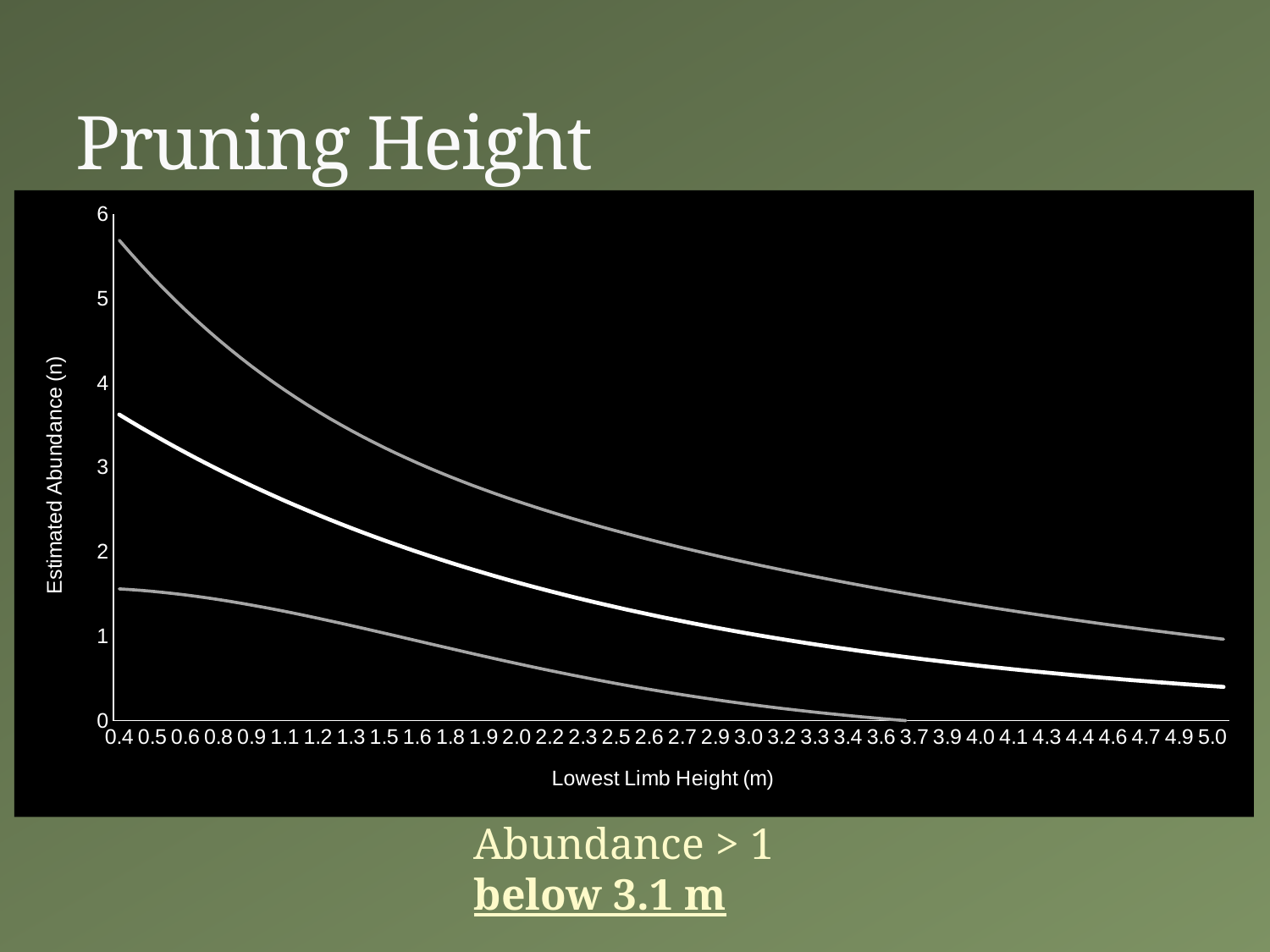
As Lowest Limb Height increases along the x axis, does the upper grey line rise or fall? Fall At a Lowest Limb Height of 0.4 m, which of the three lines has the lowest value? The lower grey line Is the value of the upper grey line at a Lowest Limb Height of 5.0 m greater or less than 2? less What is the title of the y axis of the chart? Estimated Abundance (n) Is the value of the upper grey line at a Lowest Limb Height of 0.4 m greater or less than 5? greater Is the value of the lower grey line at a Lowest Limb Height of 0.4 m greater or less than 2? less As Lowest Limb Height increases along the x axis, does the white (middle) line rise or fall? Fall At a Lowest Limb Height of 2.0 m, which line has the larger value: the upper grey line or the white line? The upper grey line What kind of chart is shown on the slide? Line chart What is the title of the x axis of the chart? Lowest Limb Height (m)